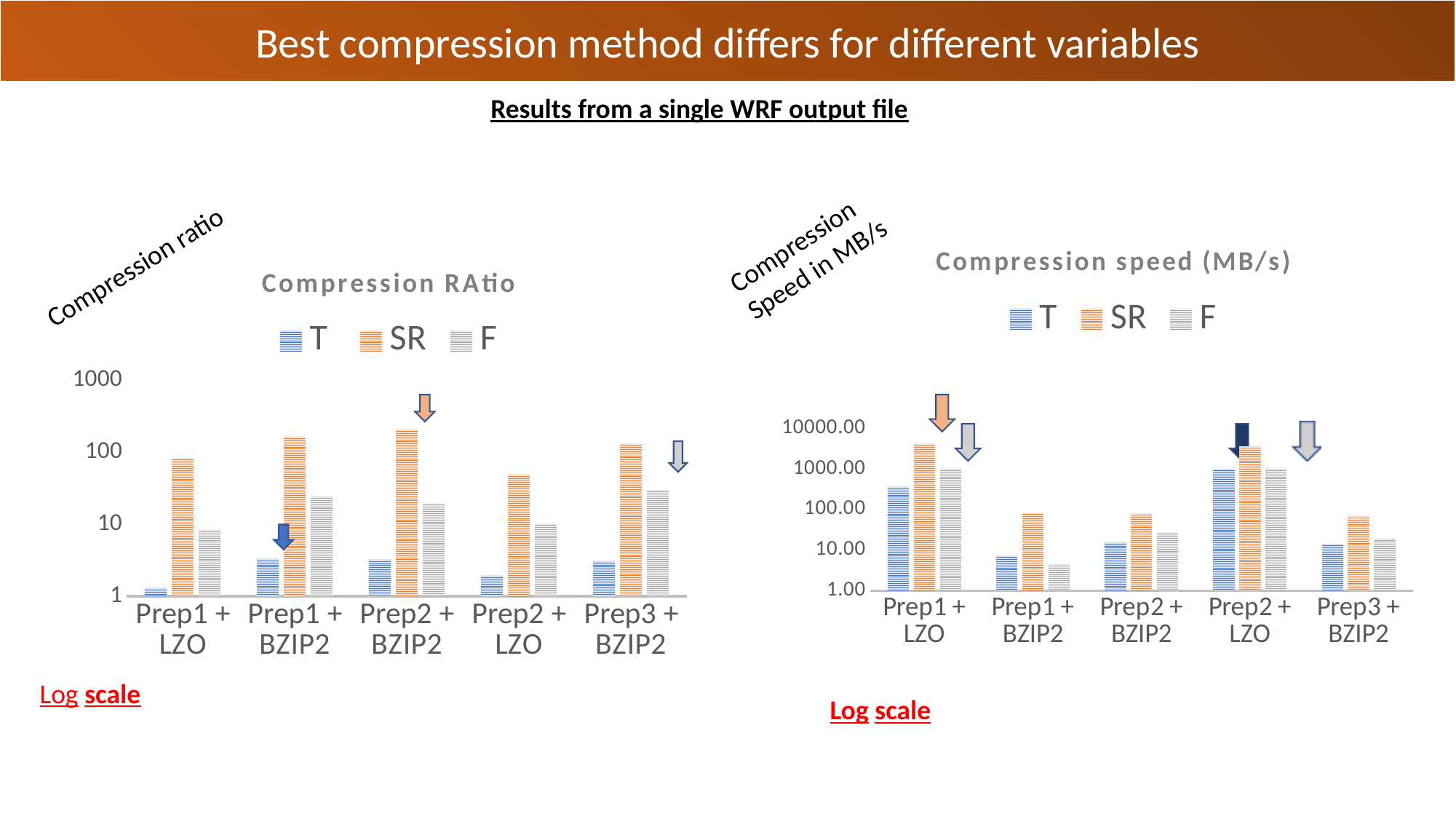
In the Compression RAtio chart, for Prep1 + LZO, which is larger: SR or F? SR In the Compression speed (MB/s) chart, which category has the highest T value? Prep2 + LZO In the Compression RAtio chart, is the SR value for Prep2 + BZIP2 greater or less than 100? greater In the Compression RAtio chart, which category has the lowest T value? Prep1 + LZO In the Compression RAtio chart, is the SR value for Prep1 + LZO greater or less than 100? less In the Compression speed (MB/s) chart, is the SR value for Prep1 + LZO greater or less than 1000.00? greater In the Compression speed (MB/s) chart, for Prep2 + LZO, which is larger: T or SR? SR What kind of chart is the Compression RAtio chart? bar chart How many series does the legend of the Compression speed (MB/s) chart list? 3 How many categories are shown on the x axis of the Compression RAtio chart? 5